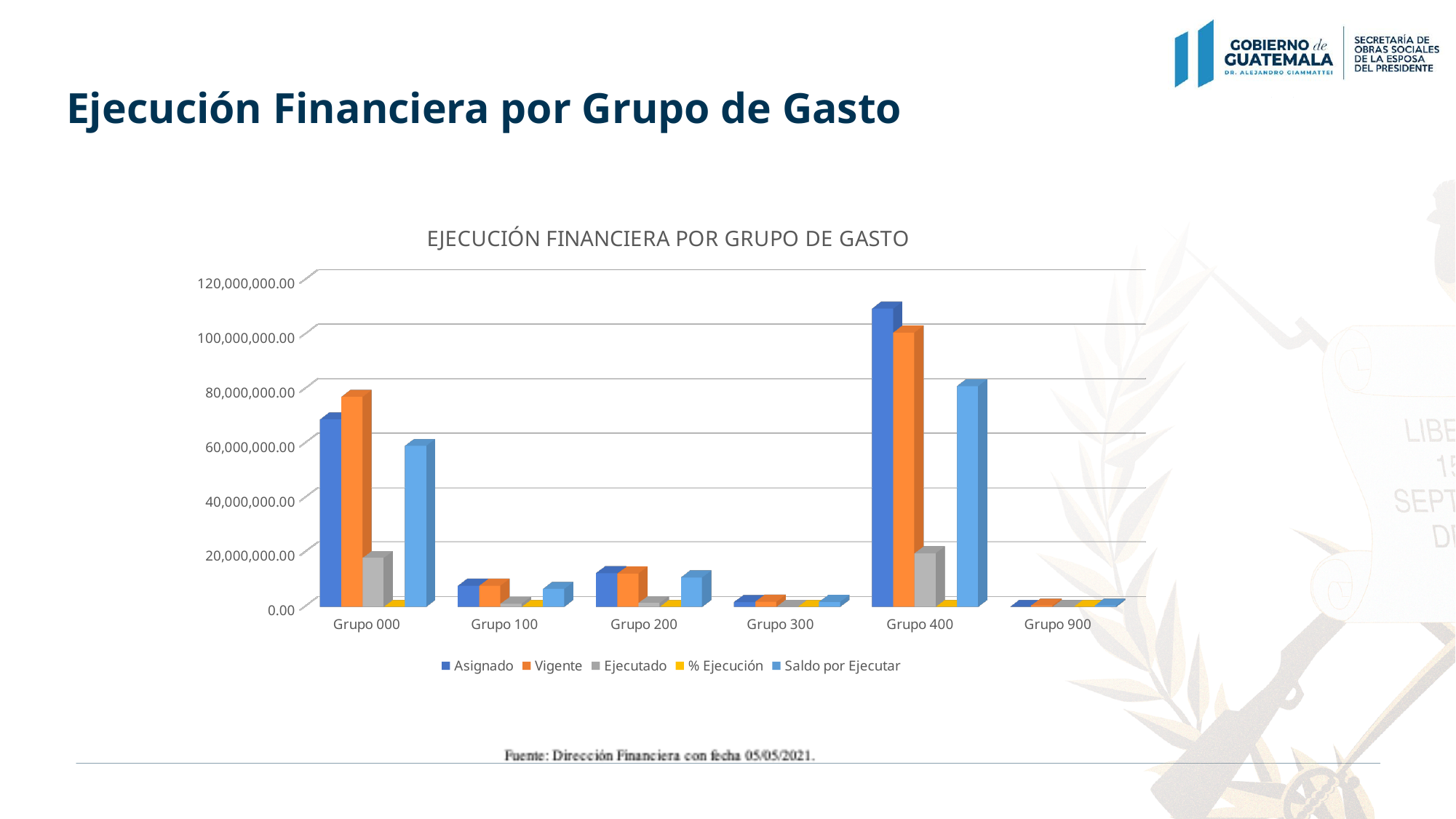
Which group has the highest Vigente value? Grupo 400 In Grupo 000, which is larger, the Asignado value or the Vigente value? Vigente What kind of chart is shown on the slide? bar chart How many groups (categories) are shown on the x axis of the chart? 6 Which is larger, the Saldo por Ejecutar value for Grupo 400 or for Grupo 000? Grupo 400 What is the title of the chart? EJECUCIÓN FINANCIERA POR GRUPO DE GASTO Is the Ejecutado value for Grupo 400 greater or less than 40,000,000.00? less Which group has the highest Asignado value? Grupo 400 How many series does the chart legend list? 5 Is the Asignado value for Grupo 400 greater or less than 100,000,000.00? greater Is the Asignado value for Grupo 000 greater or less than 60,000,000.00? greater